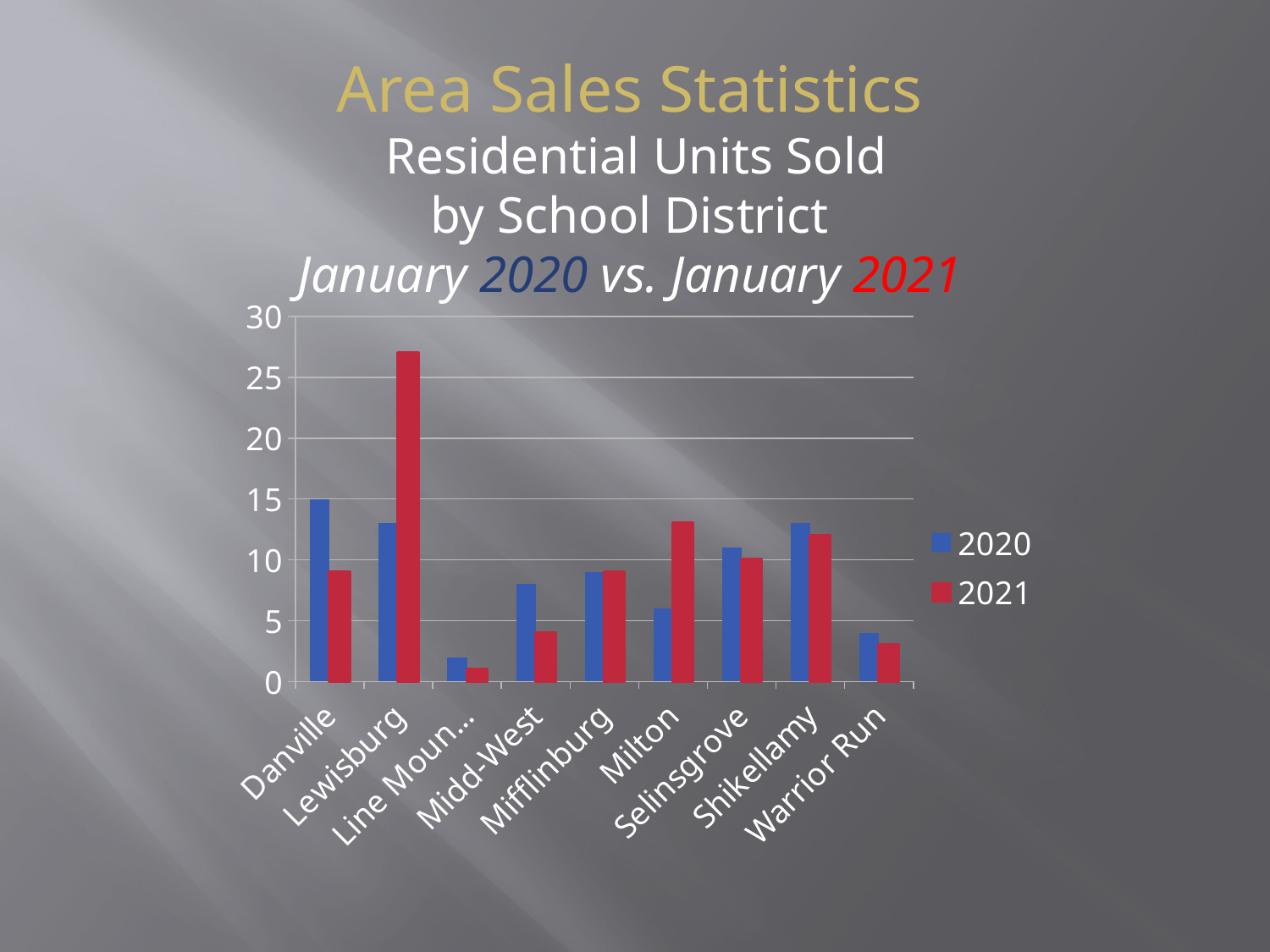
Which school district has the highest 2021 bar? Lewisburg What kind of chart is shown on the slide? bar chart Which school district has the lowest 2021 bar? Line Moun... Is the 2020 value for Midd-West greater or less than 5? greater Is the 2021 value for Milton greater or less than 10? greater How many school districts are shown on the x axis? 9 What are the two entries in the chart's legend? 2020 and 2021 How many series does the legend list? 2 For Milton, which year has the larger value, 2020 or 2021? 2021 Is the 2021 value for Danville greater or less than 10? less Which school district has the highest 2020 bar? Danville